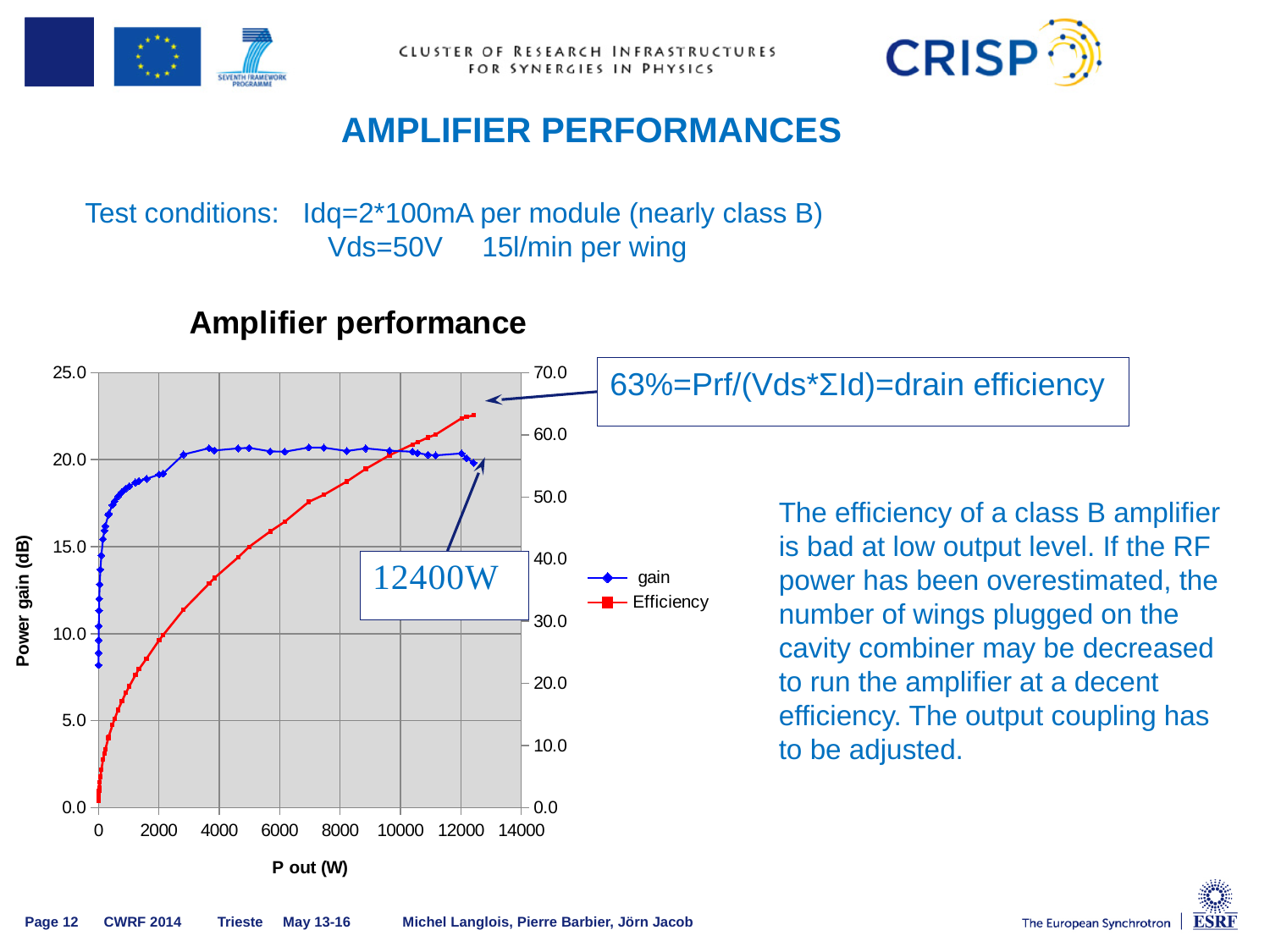
Which series is plotted in red on the chart? Efficiency Is the Power gain value at P out = 10000 W greater or less than 15.0? greater Is the Efficiency value at P out = 10000 W greater or less than 50.0? greater Does the Efficiency series rise or fall as P out increases? rise What output power is annotated at the end of the gain curve? 12400W What drain efficiency value is annotated at the top end of the Efficiency curve? 63% How many series does the legend of the Amplifier performance chart list? 2 What is the label of the x axis of the Amplifier performance chart? P out (W) Is the Efficiency value at P out = 4000 W greater or less than 30.0? greater What kind of chart is shown on the slide? line chart What are the two series named in the legend of the chart? gain and Efficiency